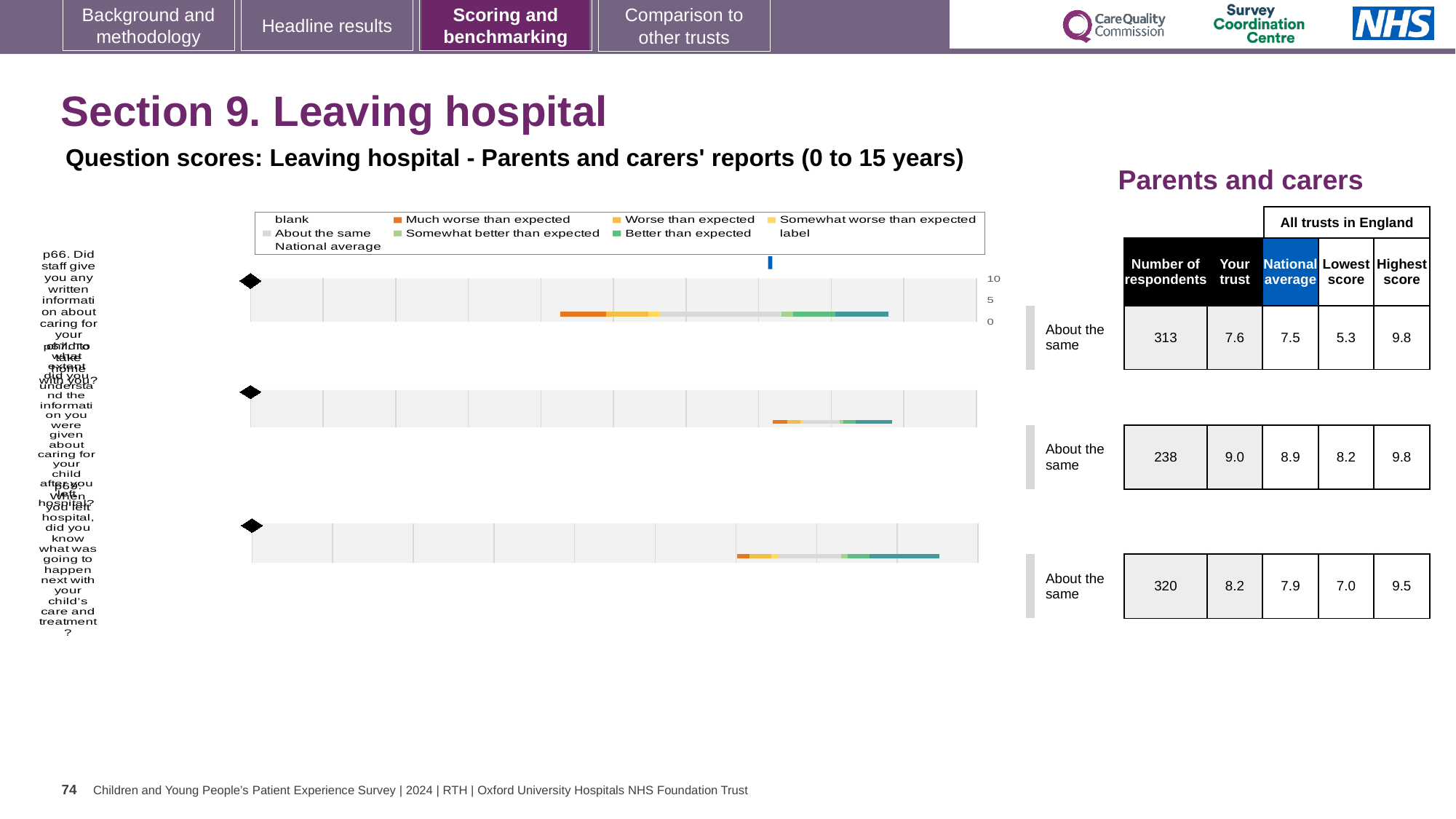
What is the number of respondents for the first (top) question row? 313 What benchmark category label is shown next to each of the three question rows? About the same What is the 'Your trust' score for the second (middle) question row? 9.0 For the third (bottom) question row, what is the difference between the 'Your trust' score and the national average? 0.3 Which question row has the lowest 'Lowest score' value? The first (top) row, 5.3 What is the national average for the third (bottom) question row? 7.9 What kind of chart is used to show the question scores on this slide? Bar chart How many question rows (bars) are plotted in the chart? 3 What is the highest score for the third (bottom) question row? 9.5 Which question row has the highest 'Your trust' score? The second (middle) row, 9.0 Which has the higher 'Your trust' score: the first (top) question row or the second (middle) question row? The second (middle) row How many entries does the chart legend list? 9